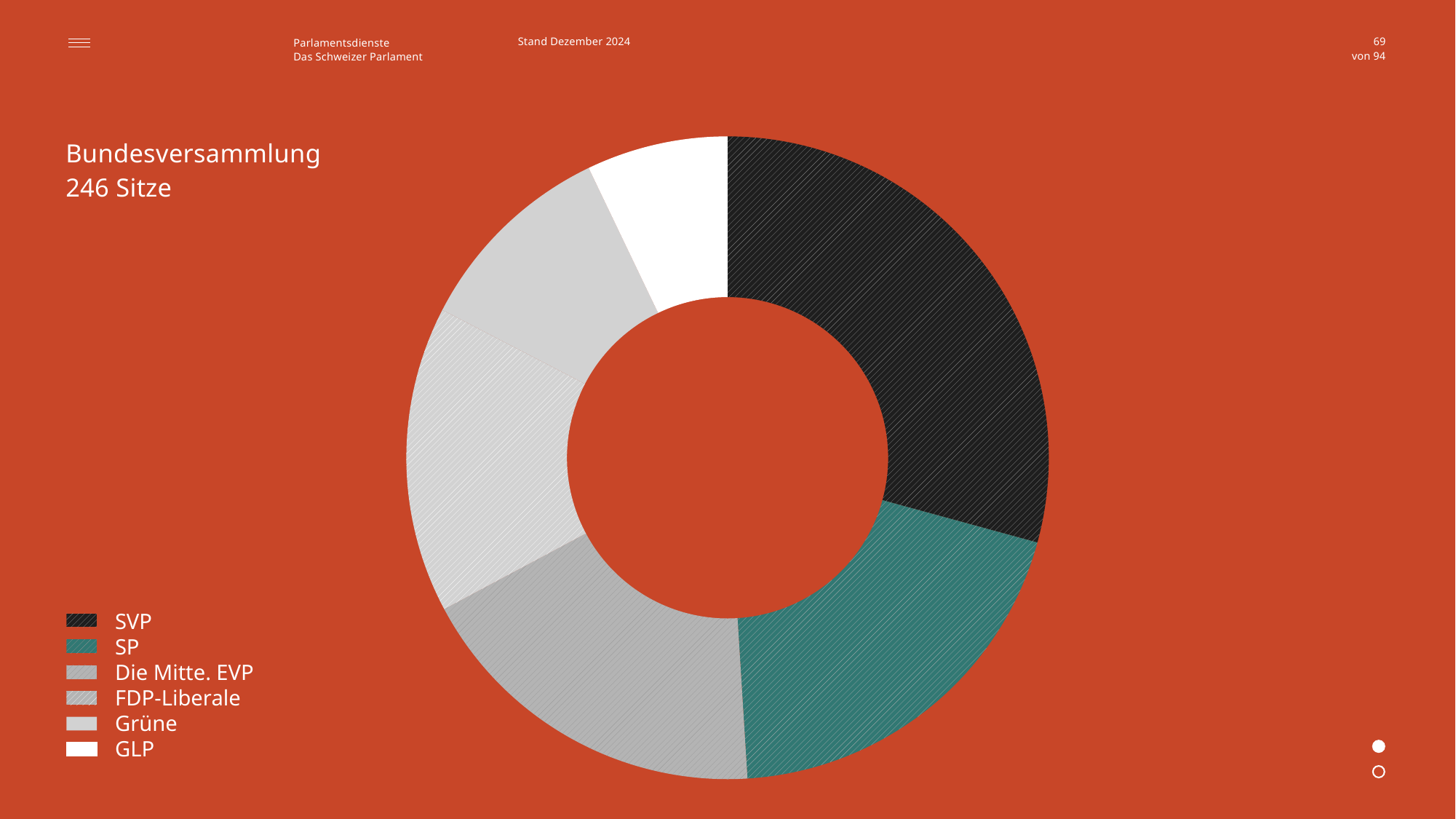
Which slice is larger, SP or GLP? SP How many slices does the pie chart have? 6 Which slice is larger, Grüne or GLP? Grüne What kind of chart is shown on the slide? Pie chart (donut) How many entries does the legend list? 6 Which party is shown in black in the legend? SVP Which party is shown in teal (green) in the pie chart? SP Which slice is larger, SVP or SP? SVP Which party has the smallest slice of the pie chart? GLP Which party has the largest slice of the pie chart? SVP What is the title of the chart? Bundesversammlung 246 Sitze